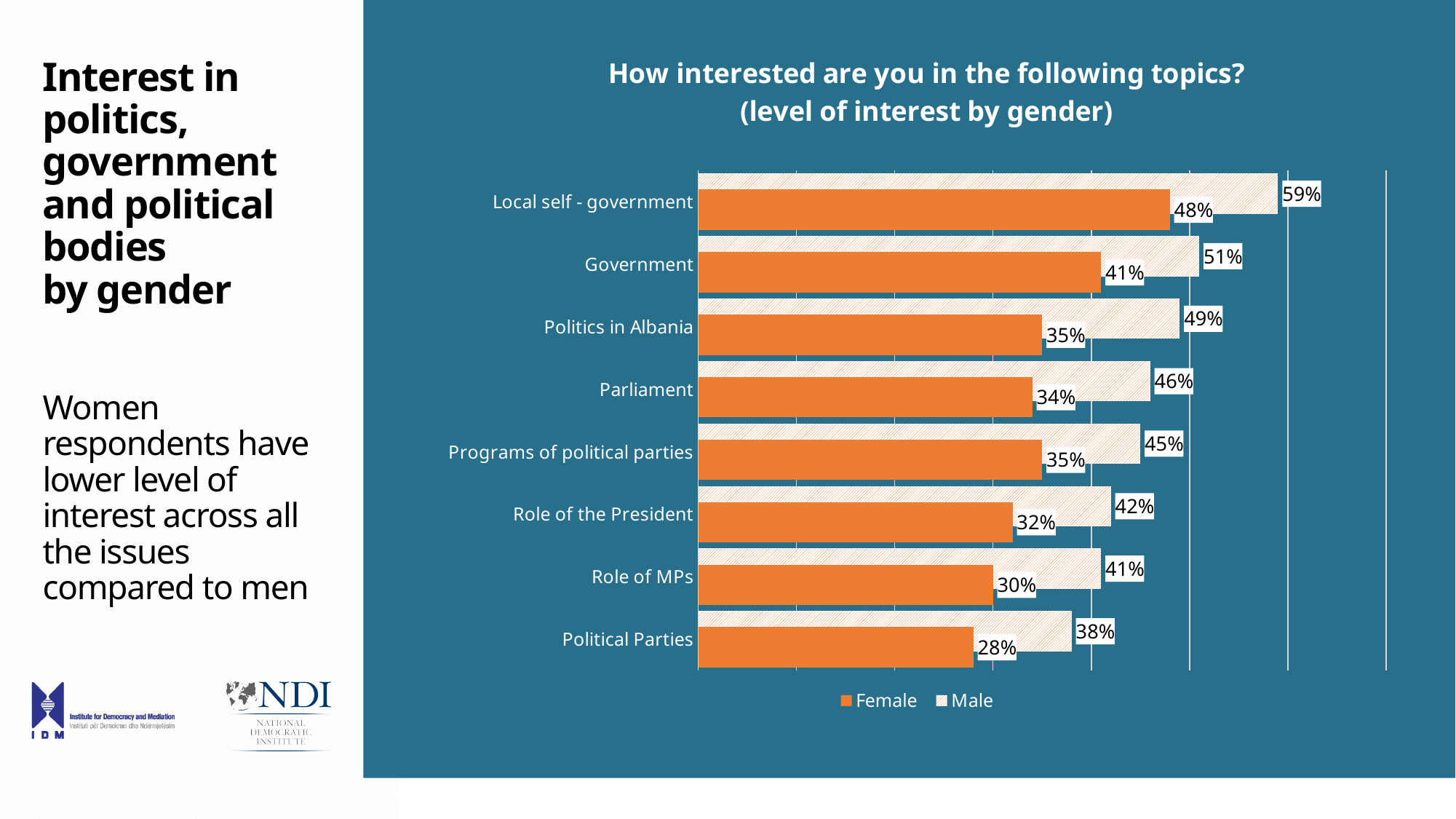
What is the difference between the Male and Female values for Parliament? 12% What is the Male value for Political Parties? 38% What is the Female value for Local self - government? 48% Which is larger, the Female value for Role of the President or the Female value for Political Parties? Role of the President What is the Female value for Role of MPs? 30% Which topic has the lowest Female value? Political Parties What is the difference between the Male and Female values for Government? 10% How many topics are shown in the chart? 8 What is the Male value for Politics in Albania? 49% Which topic has the highest Male value? Local self - government How many series does the legend list? 2 What kind of chart is shown on the slide? Bar chart